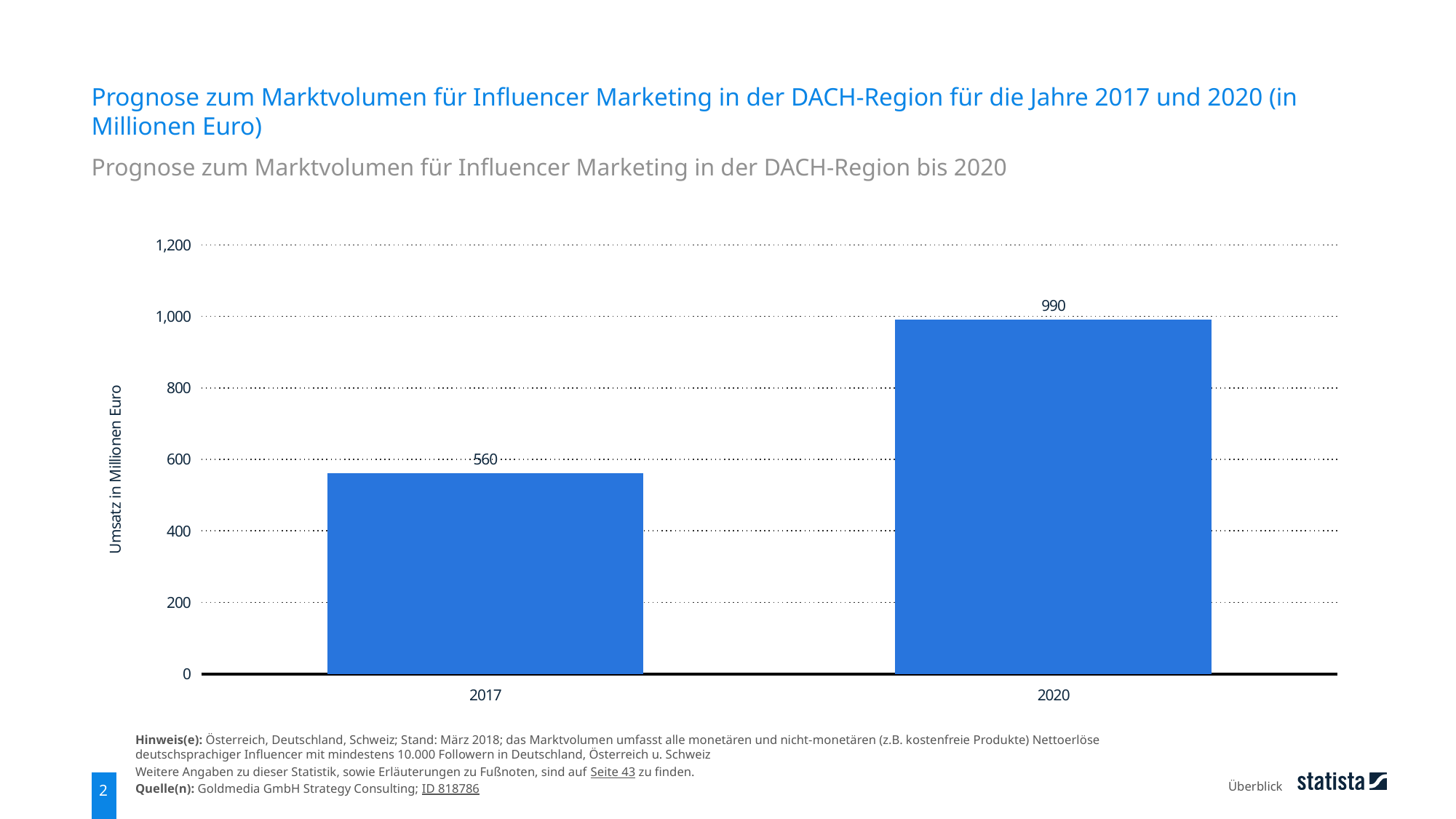
Is the value for 2020 greater or less than 800? greater What kind of chart is shown on the slide? Bar chart Which year has the lower forecast market volume? 2017 What is the label of the vertical axis? Umsatz in Millionen Euro What is the forecast market volume for influencer marketing in the DACH region for 2020? 990 By how much does the forecast market volume for 2020 exceed that for 2017? 430 Is the value for 2017 greater or less than the value for 2020? less Which year has the higher forecast market volume? 2020 What is the forecast market volume for influencer marketing in the DACH region for 2017? 560 Does the market volume rise or fall from 2017 to 2020? Rise How many years are shown on the chart? 2 Is the value for 2017 greater or less than 600? less